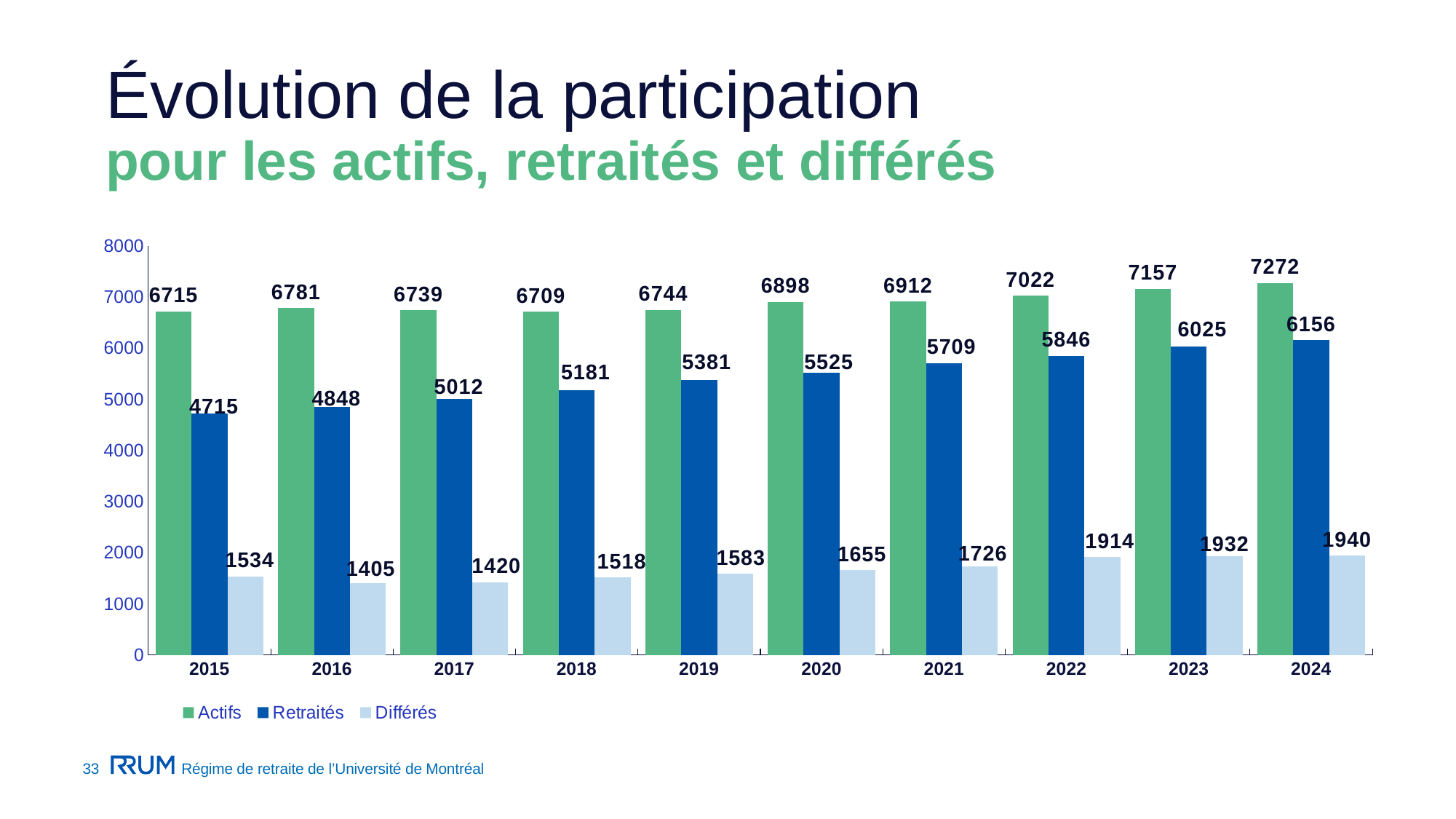
In which year is the Retraités value highest? 2024 Do the Retraités values rise or fall from 2015 to 2024? rise What is the value for Actifs in 2024? 7272 How many series does the legend list? 3 In which year is the Différés value lowest? 2016 What is the difference between the Actifs and Retraités values in 2015? 2000 Is the Retraités value for 2023 greater or less than 5000? greater What is the value for Différés in 2016? 1405 Which is larger: the Retraités value in 2020 or the Retraités value in 2021? 2021 How many years are shown on the x axis? 10 What is the value for Retraités in 2017? 5012 What kind of chart is shown on the slide? bar chart